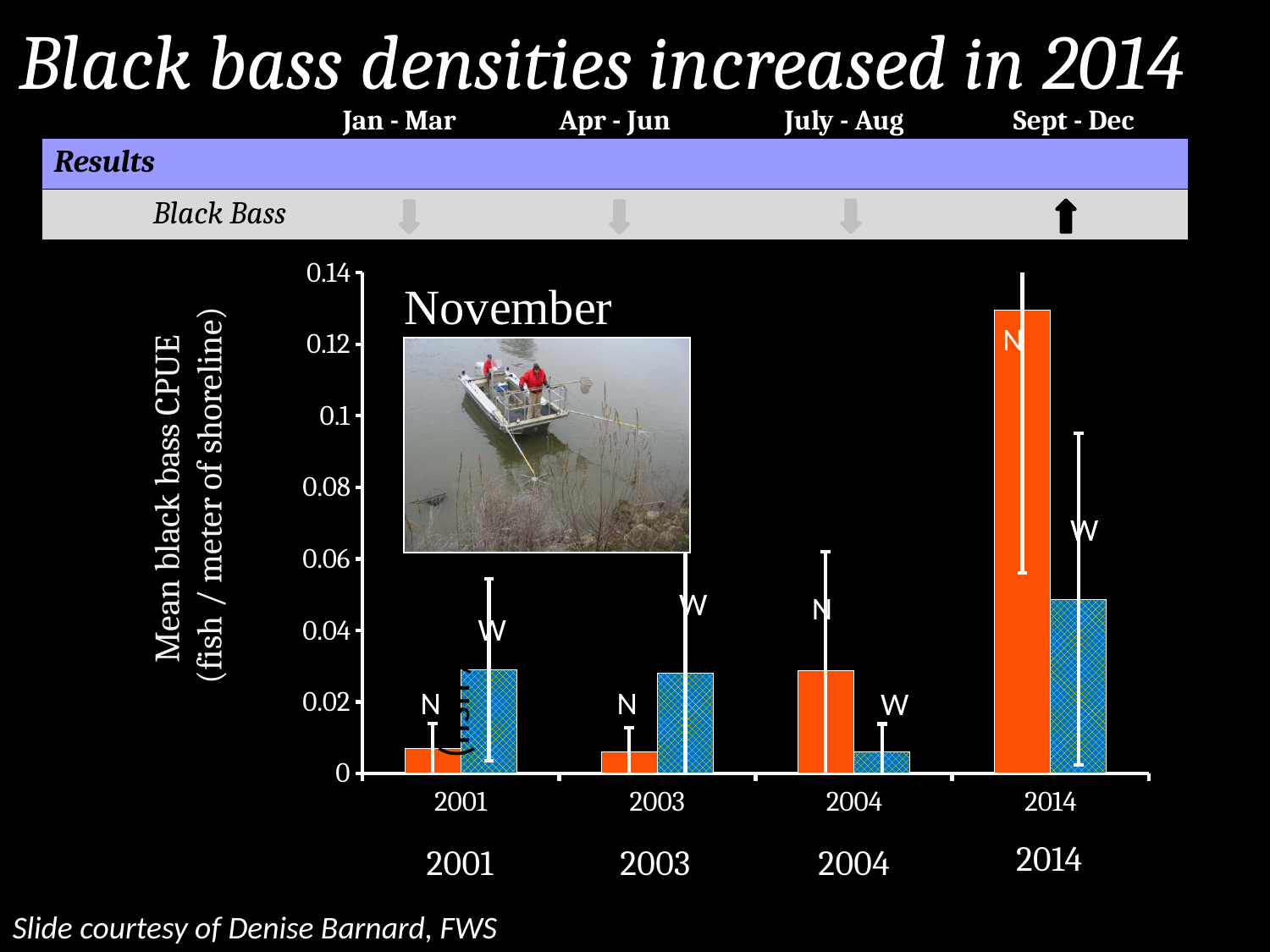
Is the N value for 2001 greater or less than 0.02? less In which year is the W bar the lowest? 2004 In which year is the N bar the highest? 2014 Is the N value for 2014 greater or less than 0.12? greater What kind of chart is shown on the slide? bar chart In 2001, which bar is taller, N or W? W What is the label of the y axis of the chart? Mean black bass CPUE (fish / meter of shoreline) In which year is the W bar the highest? 2014 How many years are shown along the x axis of the chart? 4 In 2004, which bar is taller, N or W? N How many bars are plotted for each year in the chart? 2 Is the W value for 2014 greater or less than 0.06? less